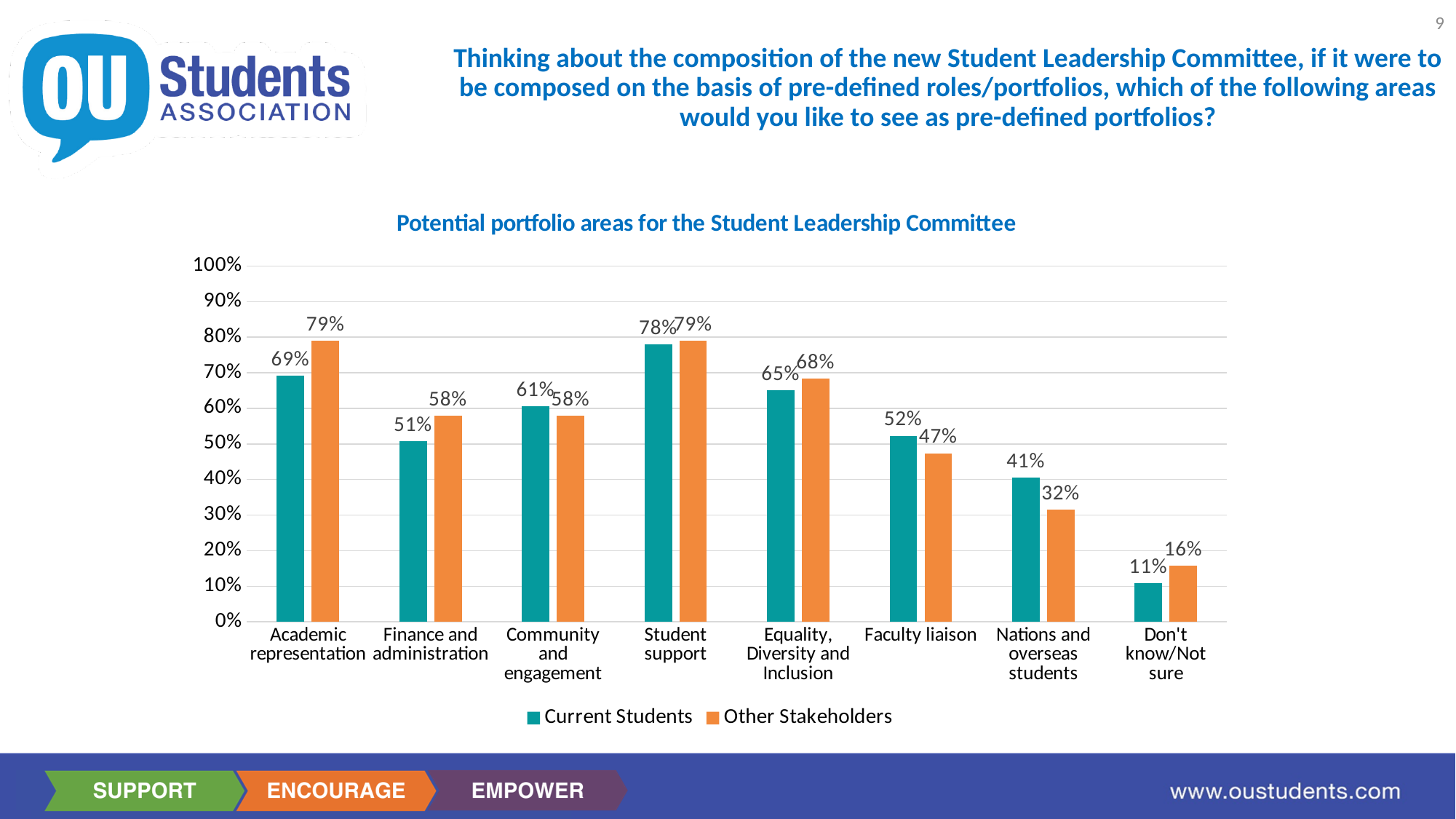
Which category has the highest value for Current Students? Student support What percentage of Other Stakeholders chose Nations and overseas students? 32% What is the title of the chart? Potential portfolio areas for the Student Leadership Committee Which category has the lowest value for Other Stakeholders? Don't know/Not sure How many categories are shown on the x axis? 8 What colour are the bars for Other Stakeholders? Orange What percentage of Current Students chose Academic representation? 69% How many series does the legend list? 2 Is the value for Current Students in Finance and administration greater or less than 60%? less What kind of chart is shown on the slide? Bar chart For Faculty liaison, which series has the larger value: Current Students or Other Stakeholders? Current Students What is the difference between Other Stakeholders and Current Students for Academic representation? 10%